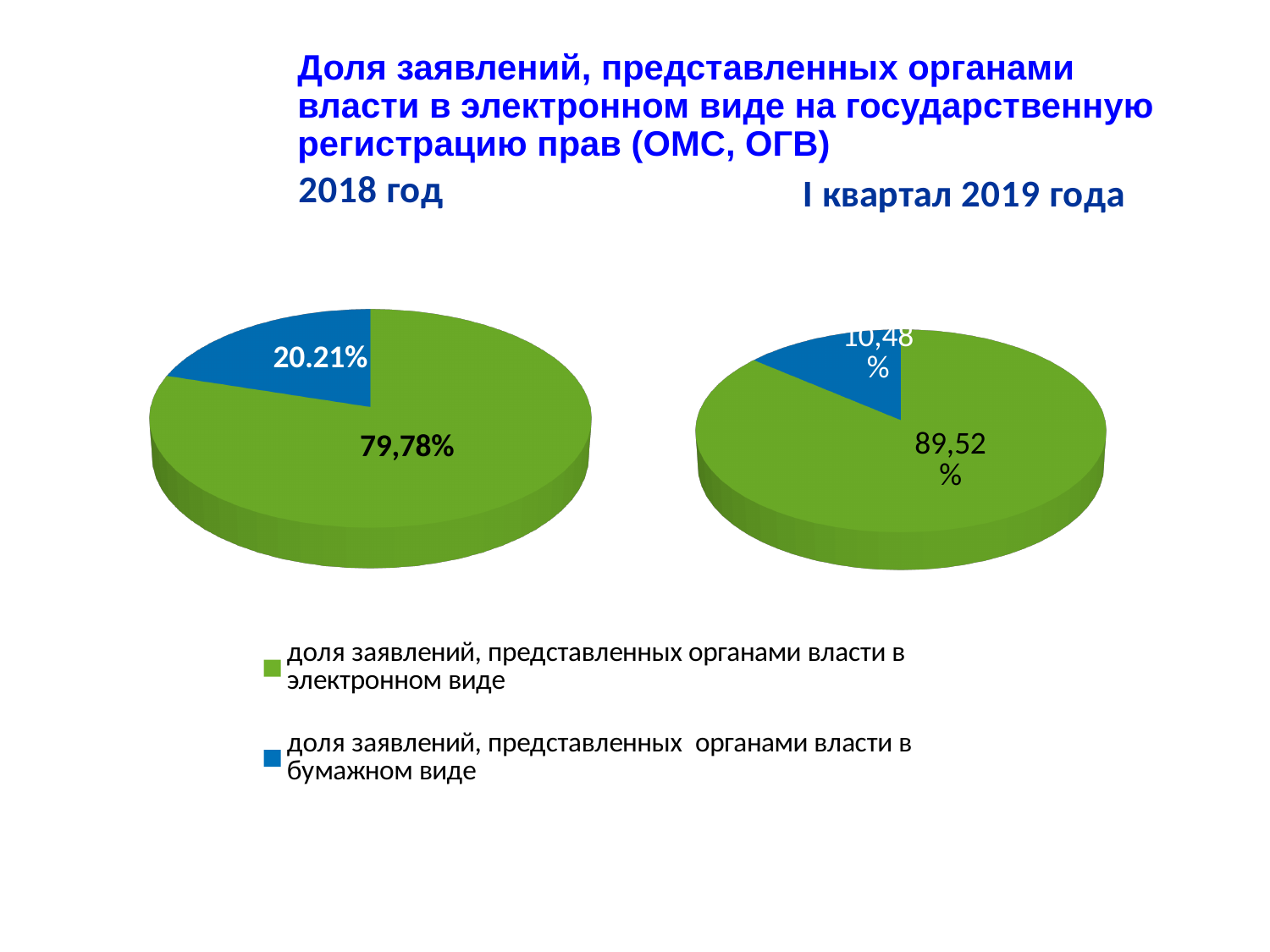
How many pie charts are shown on the slide? 2 In the I квартал 2019 года pie chart, what is the share of applications submitted on paper? 10,48% In the I квартал 2019 года pie chart, what is the share of applications submitted in electronic form? 89,52% What type of chart is used on this slide? Pie chart How many slices does the 2018 год pie chart have? 2 In the I квартал 2019 года chart, which category has the smallest slice? доля заявлений, представленных органами власти в бумажном виде What colour represents the share of applications submitted on paper (в бумажном виде)? Blue In the 2018 год pie chart, what is the share of applications submitted in electronic form (доля заявлений, представленных органами власти в электронном виде)? 79,78% In the 2018 год pie chart, what is the share of applications submitted on paper (в бумажном виде)? 20.21% In the 2018 год chart, which category has the largest slice? доля заявлений, представленных органами власти в электронном виде How many entries does the legend list? 2 Which is larger: the electronic share in the 2018 год chart or the electronic share in the I квартал 2019 года chart? I квартал 2019 года